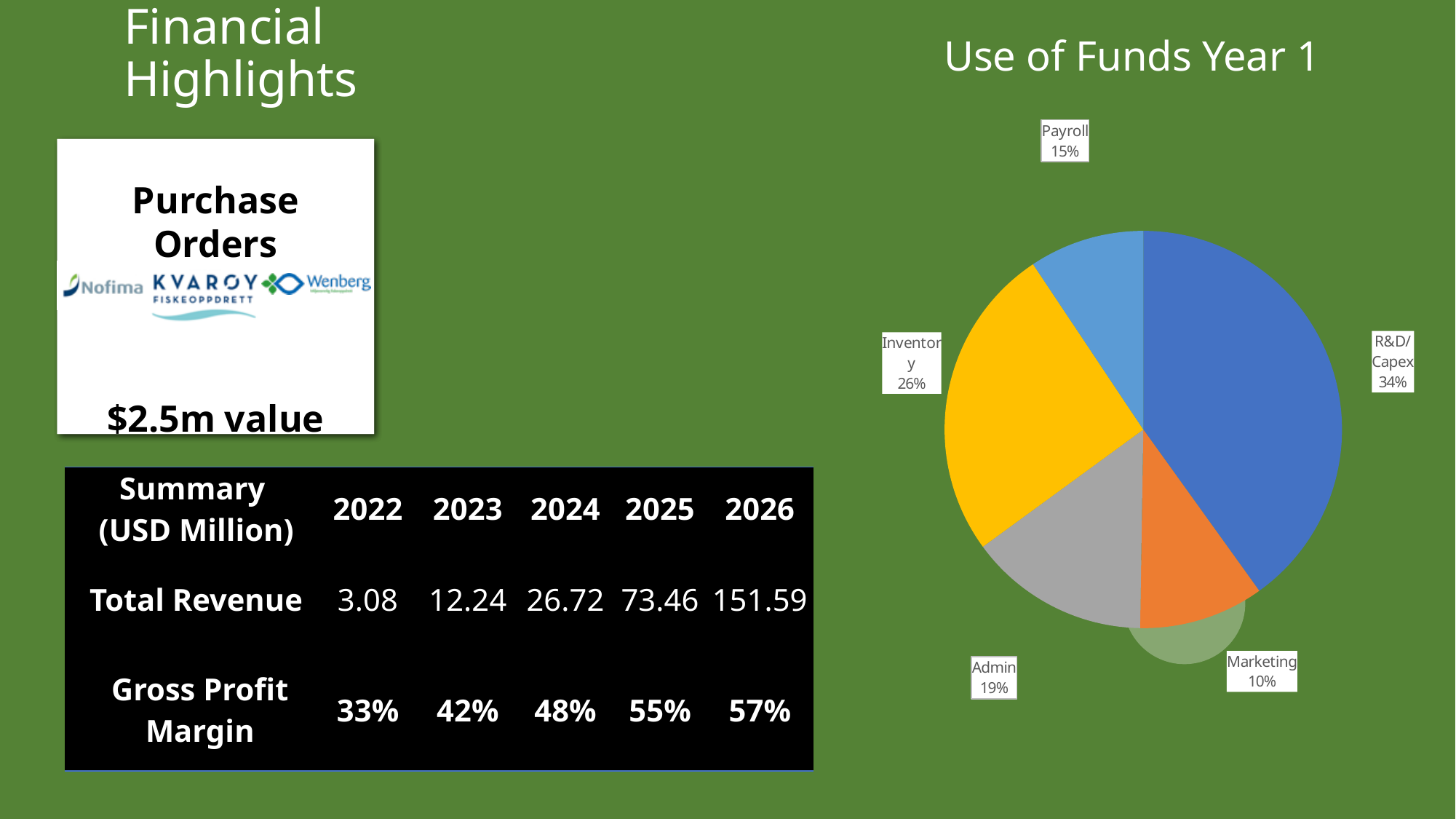
In the "Use of Funds Year 1" pie chart, what share is allocated to Marketing? 10% Which category has the smallest slice in the "Use of Funds Year 1" pie chart? Marketing What colour is the R&D/Capex slice in the "Use of Funds Year 1" pie chart? blue How many slices does the "Use of Funds Year 1" pie chart have? 5 In the "Use of Funds Year 1" pie chart, what share is allocated to Admin? 19% In the "Use of Funds Year 1" pie chart, how many percentage points larger is the R&D/Capex share than the Inventory share? 8 What type of chart is shown under the title "Use of Funds Year 1"? pie chart In the "Use of Funds Year 1" pie chart, what share is allocated to Payroll? 15% In the "Use of Funds Year 1" pie chart, what share is allocated to R&D/Capex? 34% Which category has the largest slice in the "Use of Funds Year 1" pie chart? R&D/Capex In the "Use of Funds Year 1" pie chart, which is larger: the Admin share or the Payroll share? Admin In the "Use of Funds Year 1" pie chart, what share is allocated to Inventory? 26%